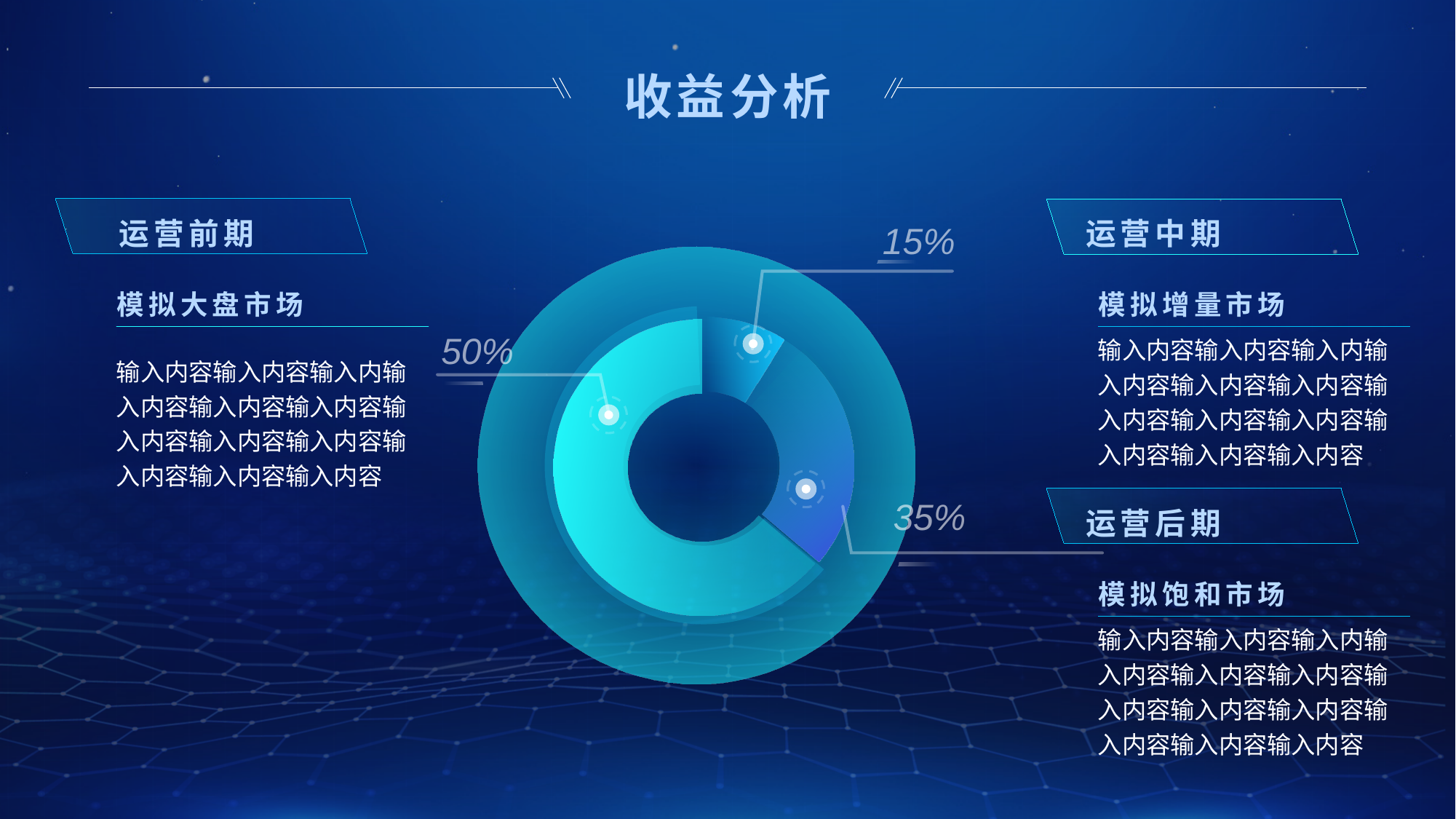
What is the difference between the 35% slice and the 15% slice? 20% What is the difference between the 50% slice and the 35% slice? 15% What is the smallest percentage shown on the donut chart? 15% What is the title of the slide containing the donut chart? 收益分析 What percentage is labelled on the large cyan slice on the left of the donut chart? 50% What kind of chart is shown on the slide? Donut (pie) chart What is the combined share of the 15% and 35% slices? 50% What percentage is labelled on the small slice at the top right of the donut chart? 15% What is the largest percentage shown on the donut chart? 50% Which slice is larger, the one labelled 35% or the one labelled 15%? 35% How many slices does the donut chart have? 3 What percentage is labelled on the dark blue slice at the lower right of the donut chart? 35%